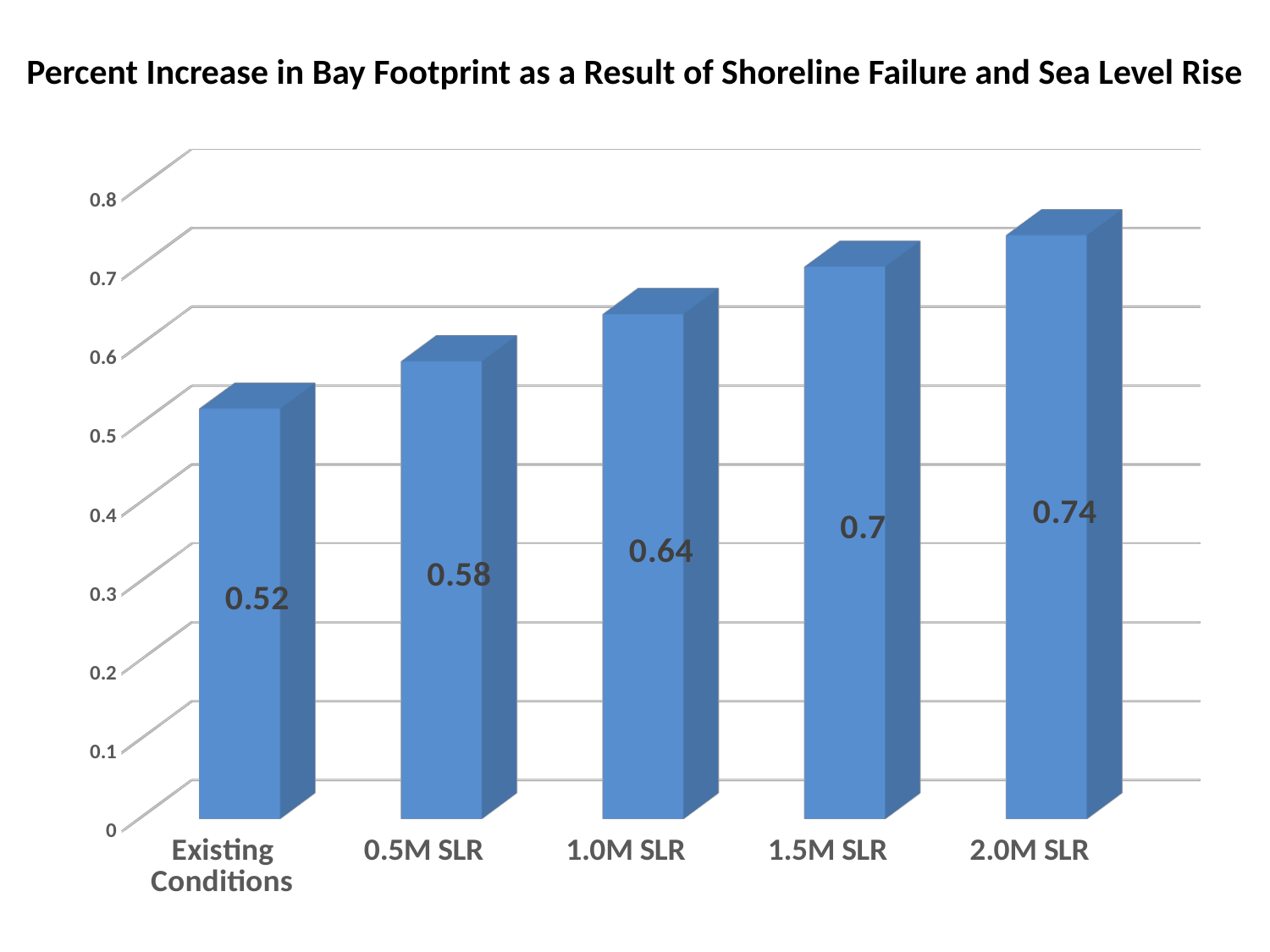
What is the difference between the values for 2.0M SLR and Existing Conditions? 0.22 Which category has the highest value? 2.0M SLR How many categories are shown on the x axis? 5 Is the value for 1.5M SLR greater or less than 0.6? greater Which is larger, the value for 0.5M SLR or the value for 1.5M SLR? 1.5M SLR Which category has the lowest value? Existing Conditions What kind of chart is shown on the slide? bar chart What is the value for 1.0M SLR? 0.64 What is the difference between the values for 1.5M SLR and 0.5M SLR? 0.12 Do the values rise or fall from Existing Conditions to 2.0M SLR? rise What is the value for Existing Conditions? 0.52 What is the value for 2.0M SLR? 0.74